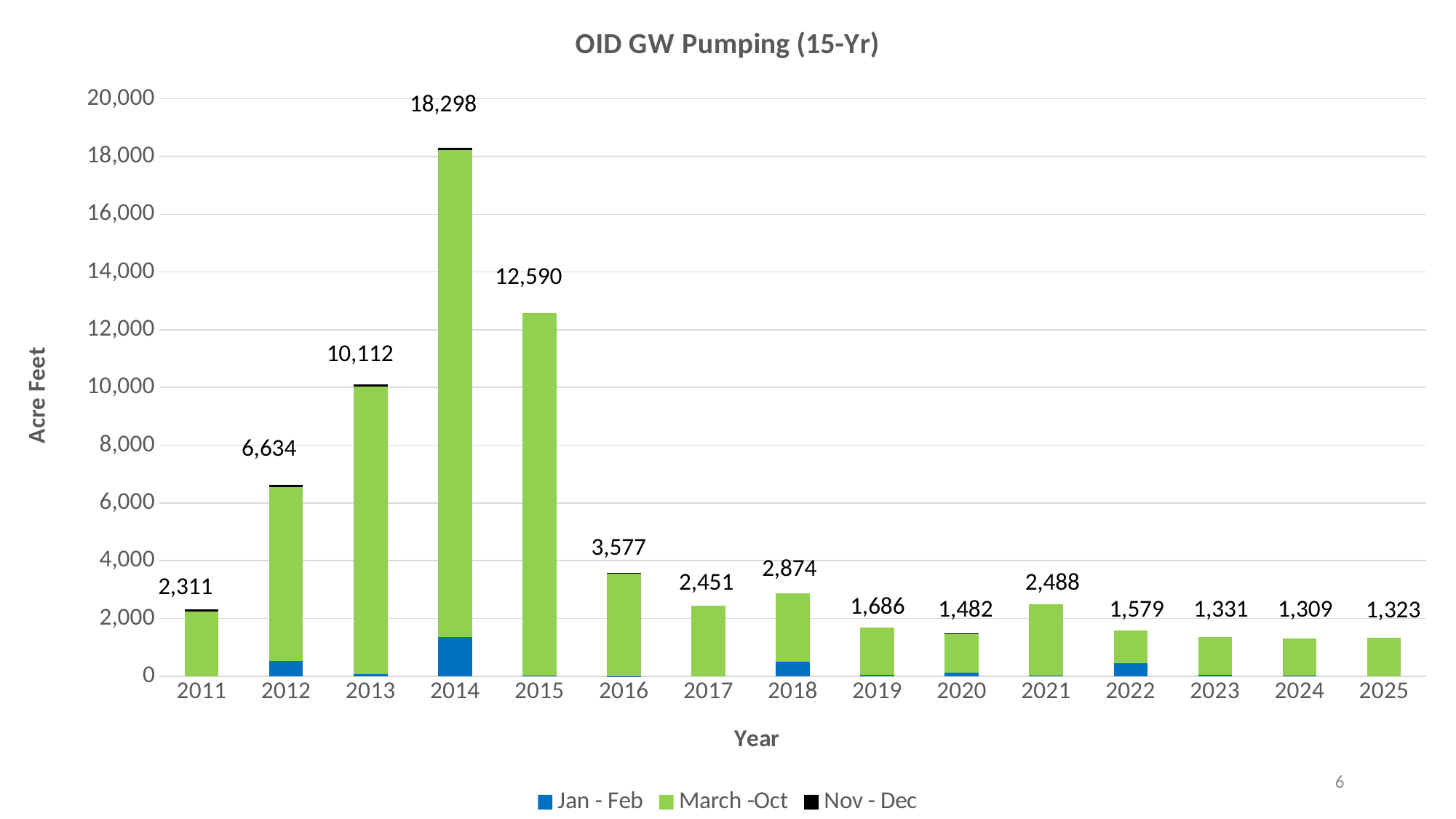
Which year has the highest total pumping? 2014 Which year has the lowest labeled total pumping? 2024 What is the total groundwater pumping labeled for 2014? 18,298 How many series does the legend list? 3 Do the total values rise or fall from 2014 to 2025? fall What is the label on the y axis? Acre Feet How many years are shown on the x axis? 15 What is the difference between the 2014 total and the 2015 total? 5,708 Is the total for 2015 greater or less than 12,000? greater Which year has a larger total, 2012 or 2013? 2013 What kind of chart is shown on the slide? Stacked bar chart What is the total value labeled for 2016? 3,577